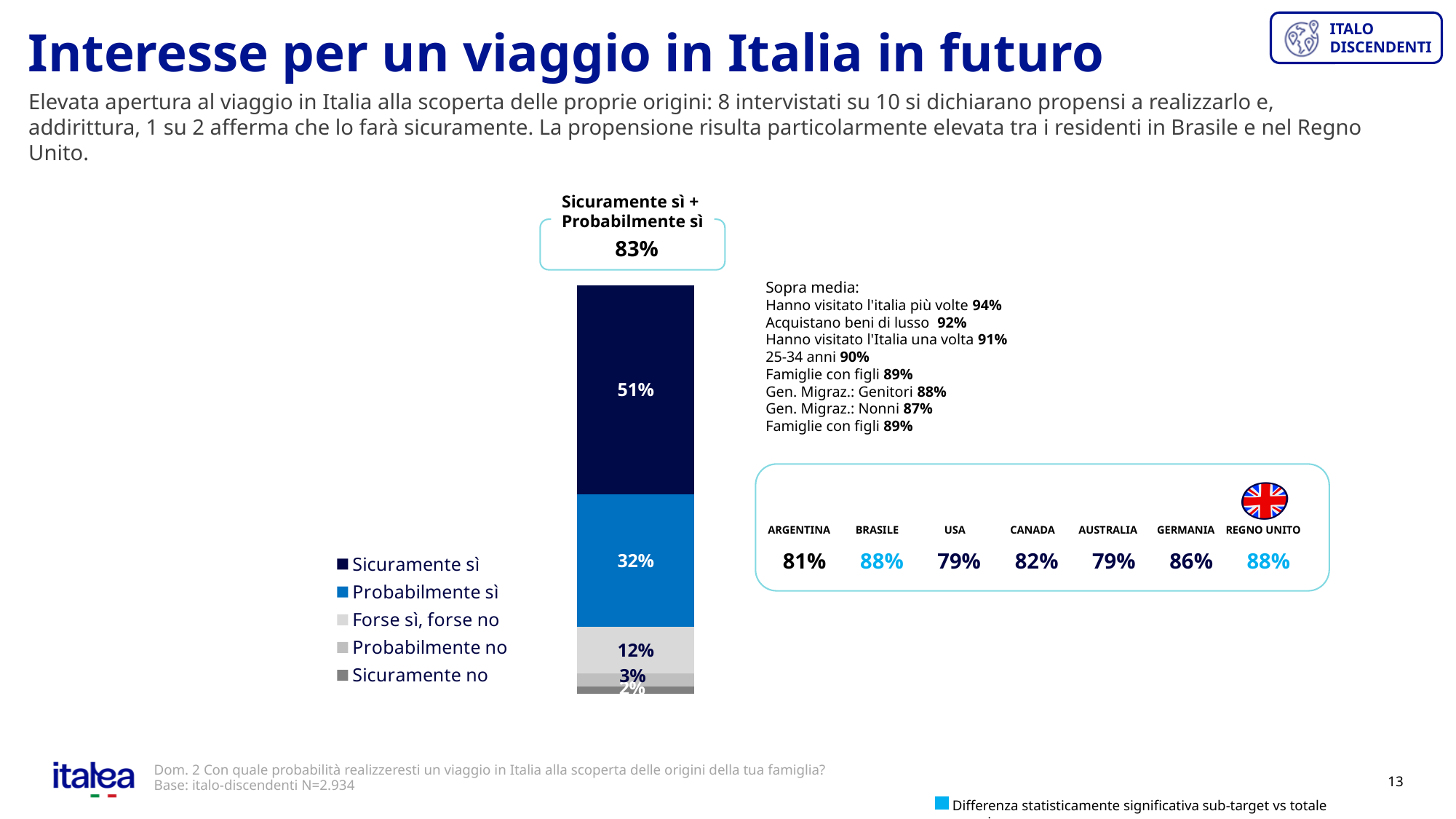
What is the value for "Probabilmente no" in the stacked bar chart? 3% What is the difference between the "Sicuramente sì" and "Probabilmente sì" values? 19 percentage points What is the value for "Sicuramente no" in the stacked bar chart? 2% Which is larger, the value for "Forse sì, forse no" or the value for "Probabilmente no"? Forse sì, forse no What kind of chart is shown on the slide? Stacked bar chart Which segment of the stacked bar has the lowest value? Sicuramente no What combined value is shown in the callout above the bar for "Sicuramente sì + Probabilmente sì"? 83% How many series does the legend of the stacked bar chart list? 5 What is the value for "Forse sì, forse no" in the stacked bar chart? 12% Which segment of the stacked bar has the highest value? Sicuramente sì What is the value for "Sicuramente sì" in the stacked bar chart? 51% What is the value for "Probabilmente sì" in the stacked bar chart? 32%